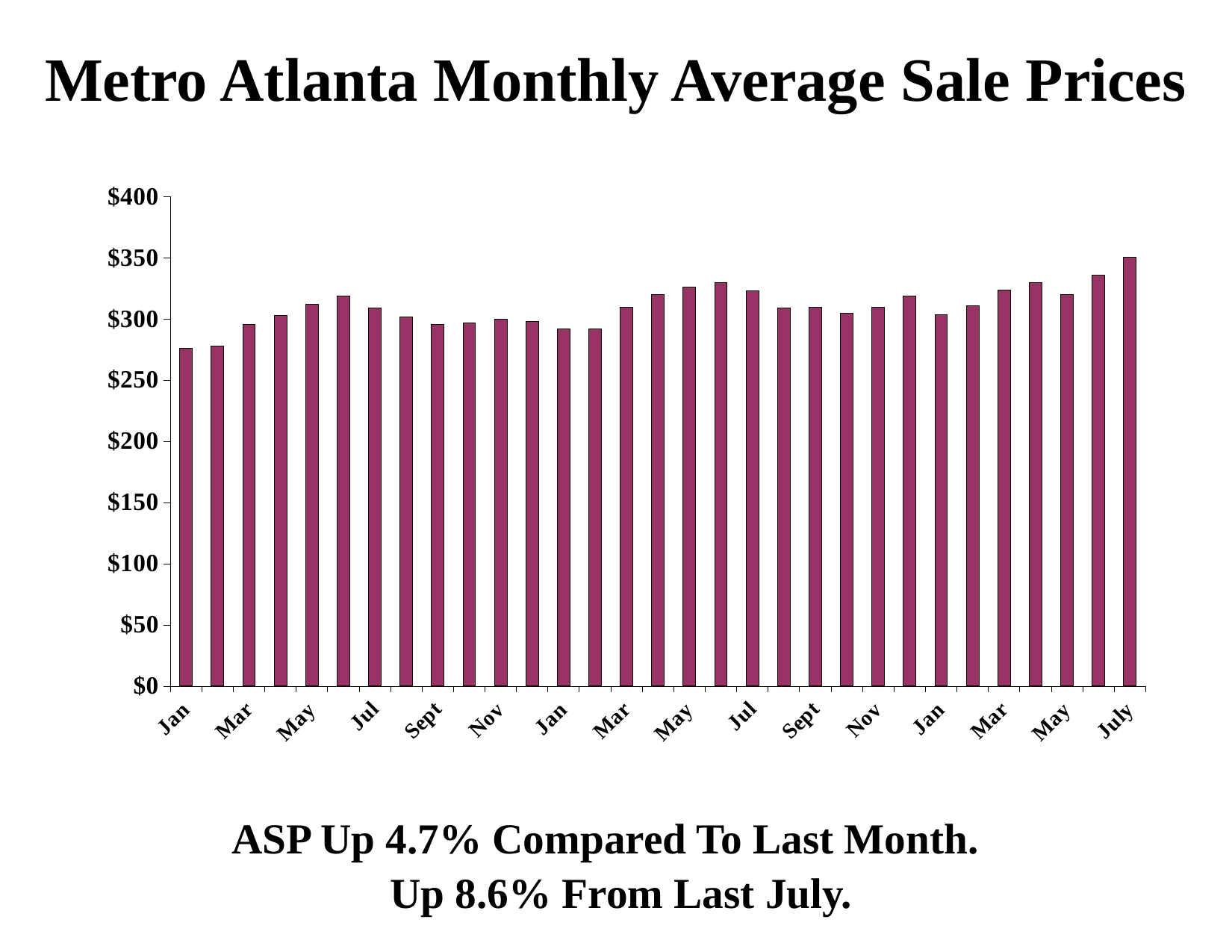
Do the values generally rise or fall from the first bar to the last bar? rise Which bar is the highest in the chart? July (the last bar) Is the value for the first Jan bar greater or less than $250? greater Which is larger, the first Jan bar or the last July bar? July (the last bar) Is the value for the first Jan bar greater or less than $300? less What kind of chart is shown on the slide? bar chart How many bars are plotted in the chart? 31 Which bar is the lowest in the chart? Jan (the first bar) What is the highest value shown on the vertical axis? $400 Is the value for the last July bar greater or less than $300? greater Which is larger, the first Jan bar or the first Mar bar? Mar What is the title of the chart? Metro Atlanta Monthly Average Sale Prices